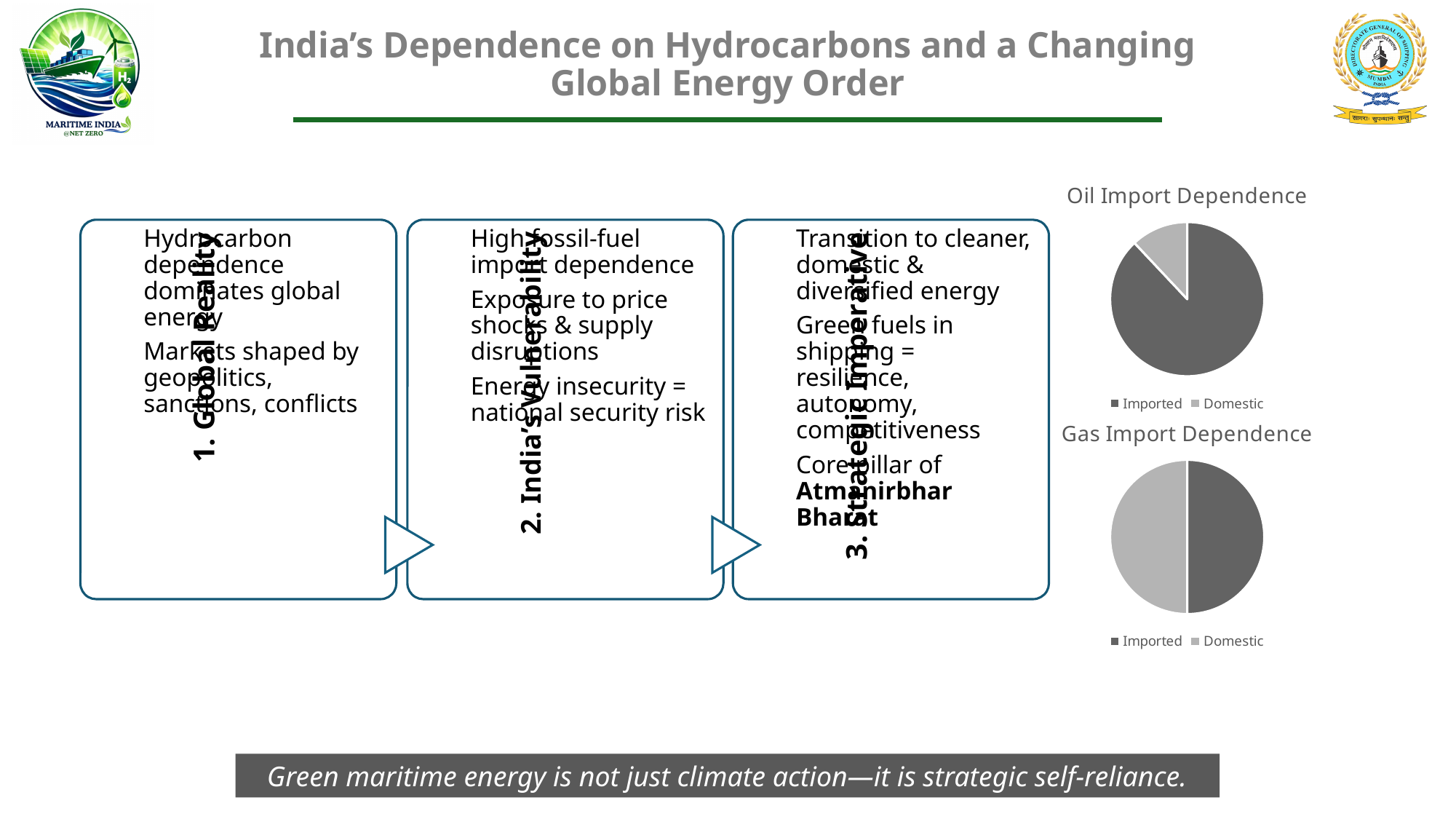
How many slices does the Oil Import Dependence pie chart have? 2 How many entries does the legend of the Gas Import Dependence chart list? 2 What kind of chart is the Oil Import Dependence chart? Pie chart In the Oil Import Dependence chart, which slice is the smallest? Domestic In the Oil Import Dependence chart, which slice is the largest? Imported In the Oil Import Dependence chart, is the Imported slice larger or smaller than the Domestic slice? Larger What kind of chart is the Gas Import Dependence chart? Pie chart What is the title of the lower pie chart on the slide? Gas Import Dependence What are the legend entries of the Oil Import Dependence chart? Imported, Domestic How many slices does the Gas Import Dependence pie chart have? 2